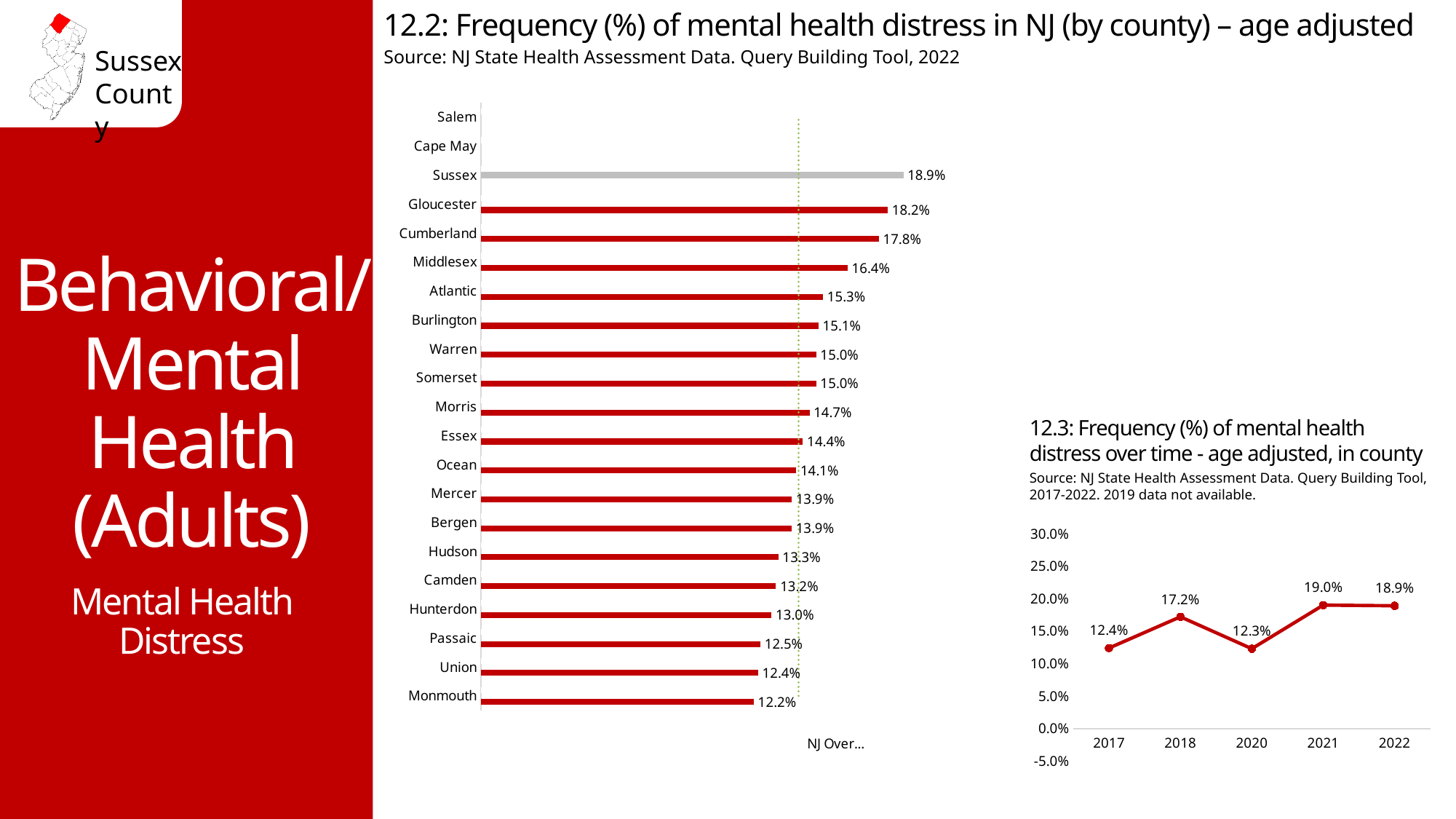
In chart 12.2, what is the value shown for Middlesex? 16.4% In chart 12.3, what is the value for 2021? 19.0% In chart 12.2, what is the frequency of mental health distress for Sussex? 18.9% In chart 12.2, which county has the highest value shown? Sussex In chart 12.2, which has a higher value, Atlantic or Hudson? Atlantic How many years are plotted in chart 12.3? 5 In chart 12.3, which year has the lowest value? 2020 What kind of chart is chart 12.2? Bar chart In chart 12.3, what is the difference between the 2018 and 2017 values? 4.8% In chart 12.2, which county has the lowest value shown? Monmouth What kind of chart is chart 12.3? Line chart In chart 12.2, what is the difference between the values for Sussex and Gloucester? 0.7%